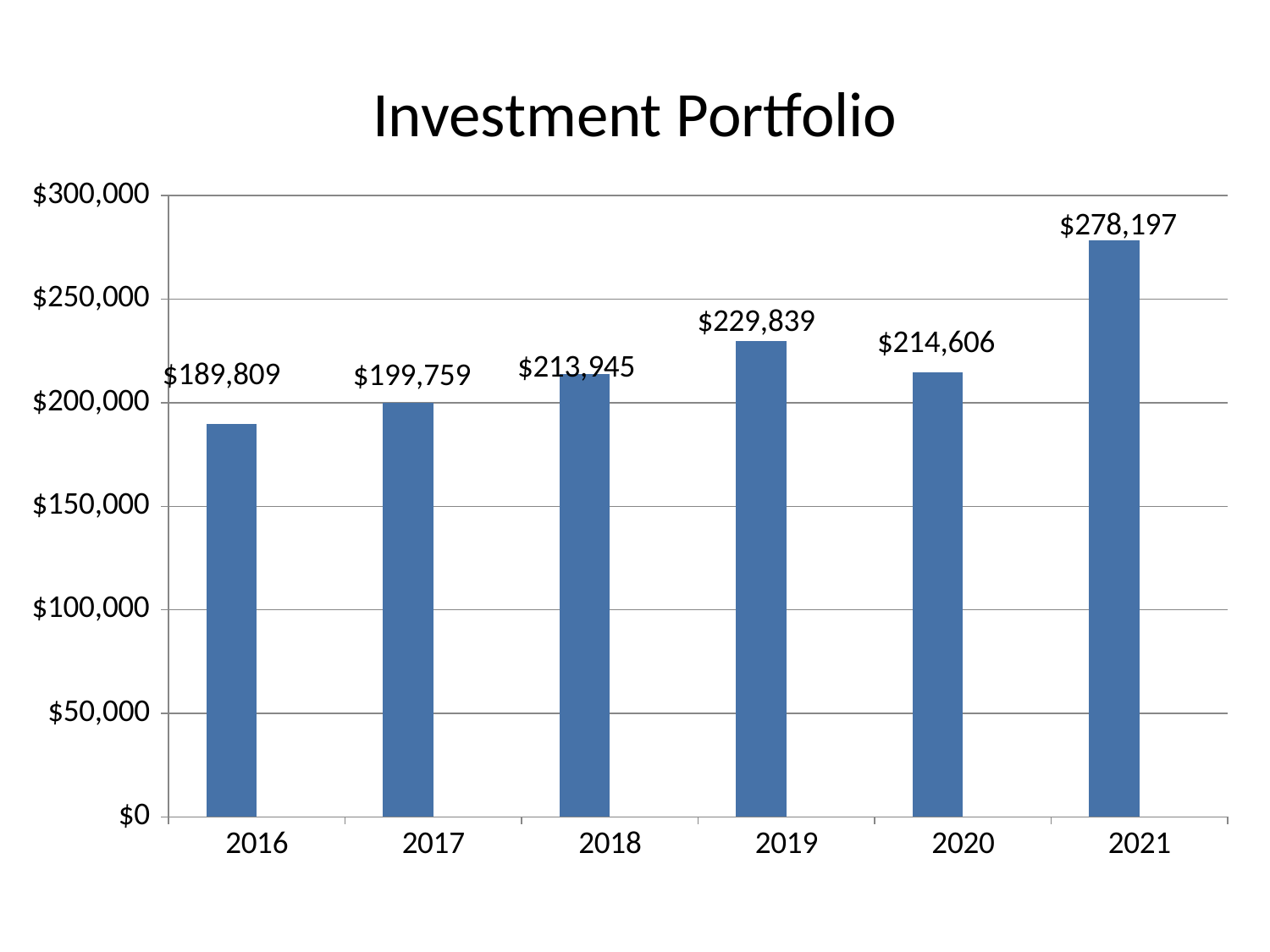
What is the value of the investment portfolio in 2016? $189,809 Is the value for 2017 greater or less than $250,000? less What is the difference between the 2021 and 2020 portfolio values? $63,591 What is the value of the investment portfolio in 2020? $214,606 Which year has the highest investment portfolio value? 2021 What kind of chart is shown on the slide? bar chart Which year has a larger portfolio value, 2019 or 2020? 2019 What is the difference between the 2017 and 2016 portfolio values? $9,950 How many years are shown on the chart? 6 What is the title of the chart? Investment Portfolio What is the value of the investment portfolio in 2019? $229,839 Which year has the lowest investment portfolio value? 2016